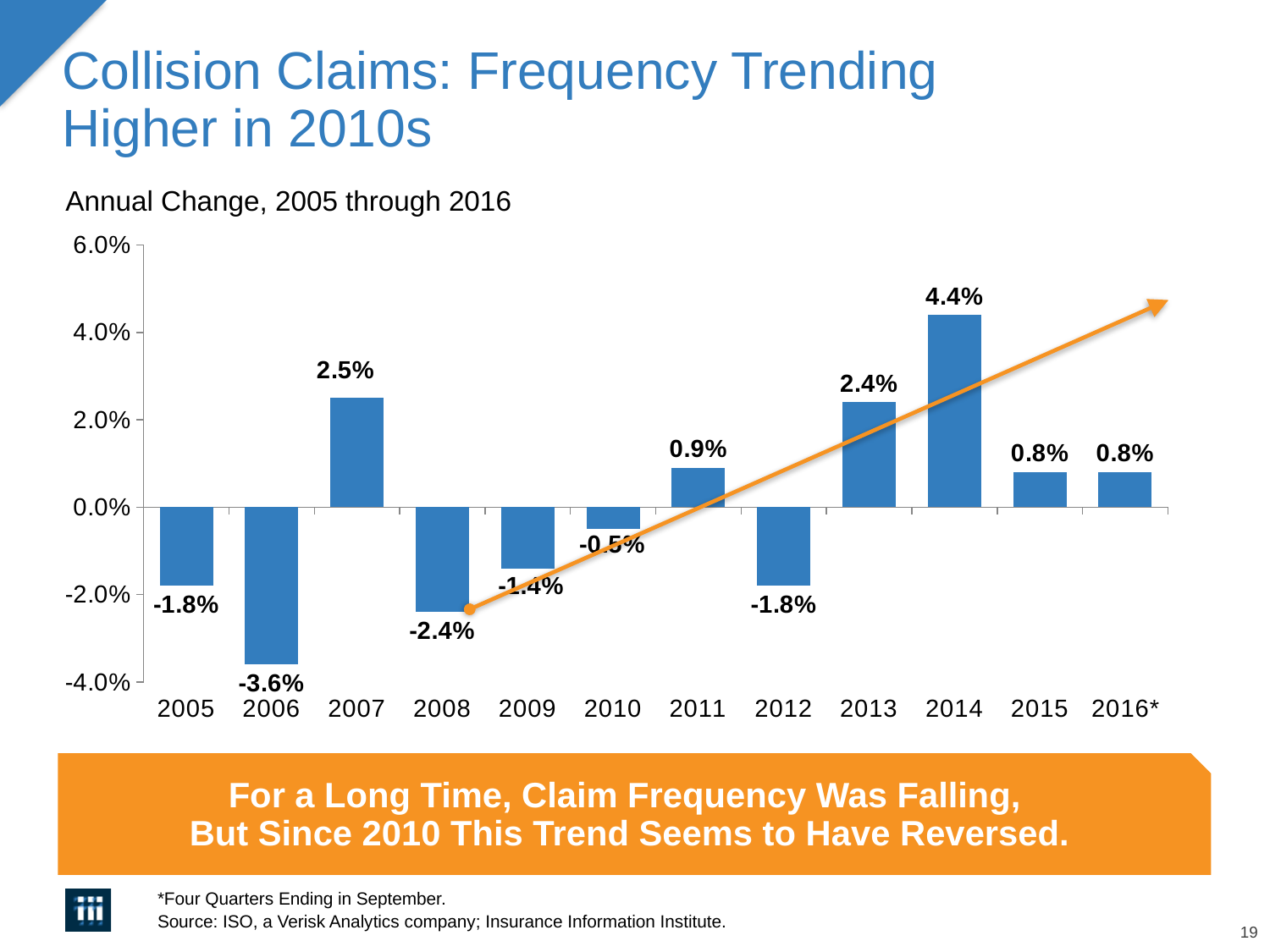
What is the difference between the annual change in 2014 and the annual change in 2013? 2.0% How many years are shown on the x axis of the chart? 12 Which year has the highest annual change in collision claim frequency? 2014 Is the value for 2014 greater or less than 4.0%? greater What is the subtitle printed above the chart? Annual Change, 2005 through 2016 Do the annual change values generally rise or fall from 2008 to 2014? rise Which year has the lowest annual change in collision claim frequency? 2006 What kind of chart is used to show the annual change in collision claim frequency? bar chart What is the annual change in collision claim frequency for 2014? 4.4% Which year has a larger annual change, 2007 or 2013? 2007 What is the annual change in collision claim frequency for 2006? -3.6% What is the annual change in collision claim frequency for 2011? 0.9%